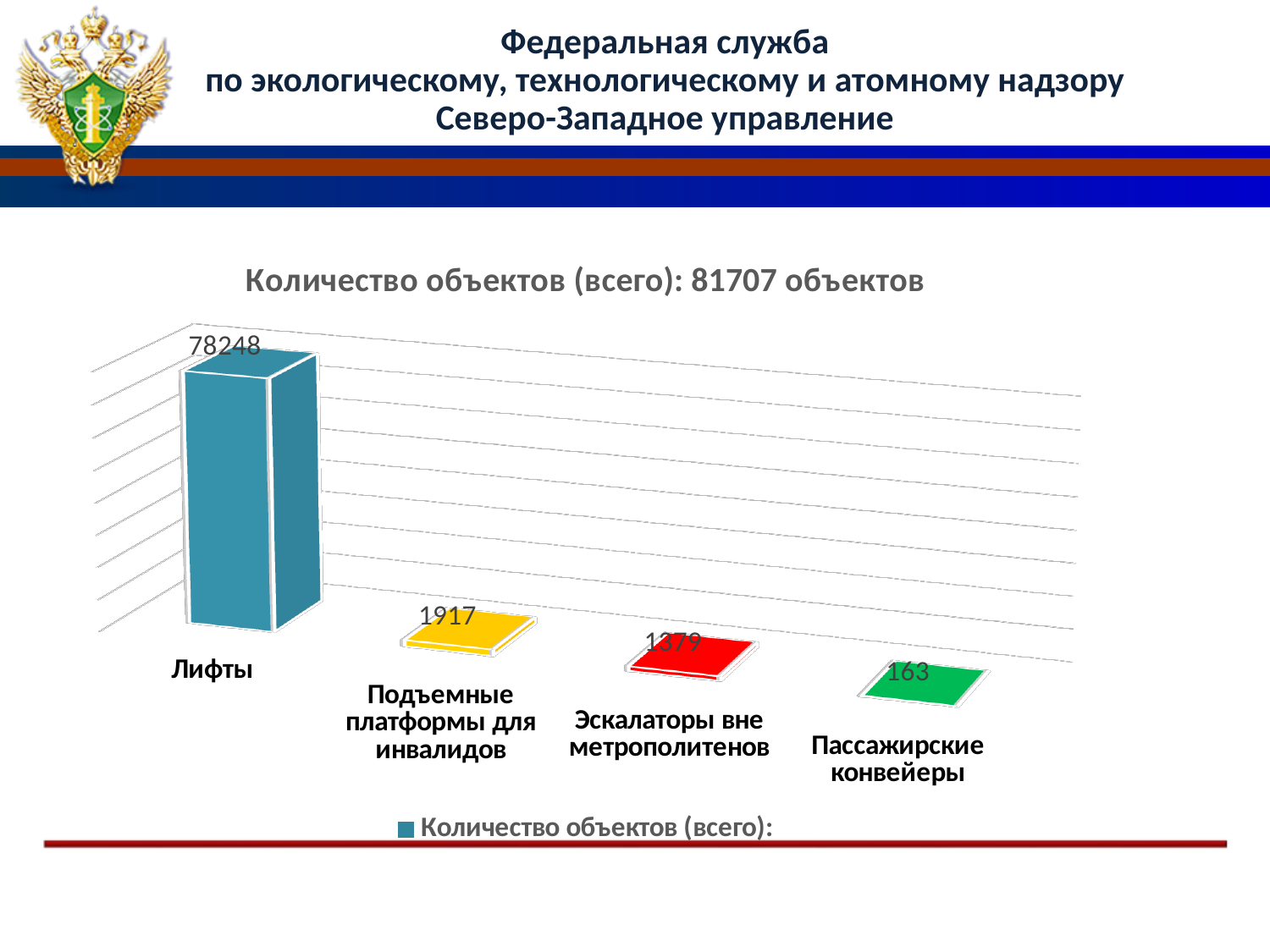
How many series does the legend list? 1 What is the difference between the values for Лифты and Пассажирские конвейеры? 78085 How many categories are shown in the chart? 4 Which category has the highest value? Лифты Which is larger, the value for Эскалаторы вне метрополитенов or the value for Пассажирские конвейеры? Эскалаторы вне метрополитенов Which category has the lowest value? Пассажирские конвейеры What kind of chart is shown on the slide? Bar chart What is the value for Пассажирские конвейеры? 163 What is the difference between the values for Подъемные платформы для инвалидов and Эскалаторы вне метрополитенов? 538 What is the value for Лифты? 78248 What is the value for Подъемные платформы для инвалидов? 1917 What is the value for Эскалаторы вне метрополитенов? 1379